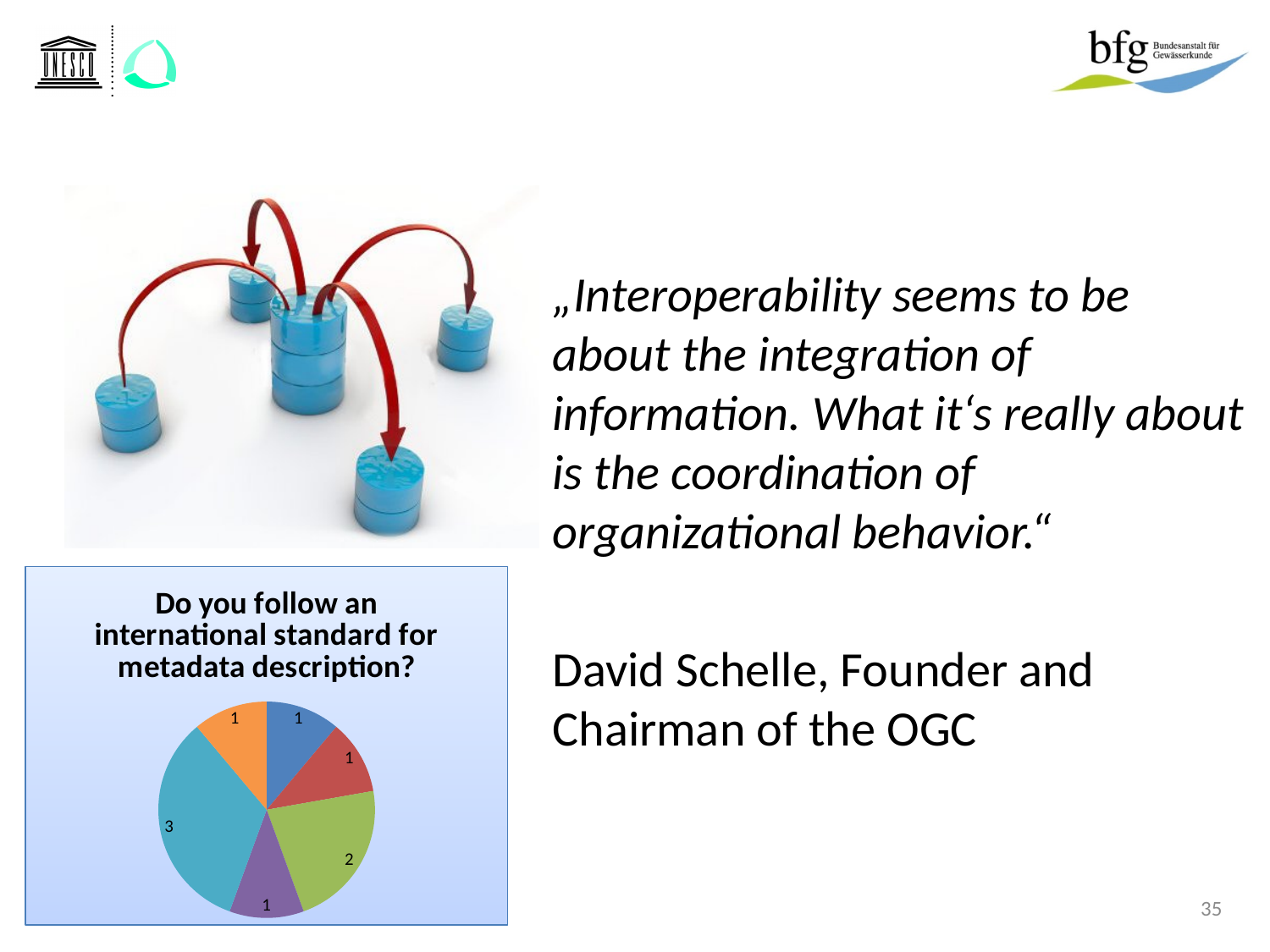
What is the title of the pie chart? Do you follow an international standard for metadata description? Which is larger in the pie chart, the teal slice or the green slice? the teal slice What colour is the largest slice of the pie chart? teal (light blue) How many slices in the pie chart have a value of 1? 4 What is the total of all the values shown on the pie chart? 9 How many slices does the pie chart have? 6 What is the value of the green slice in the pie chart? 2 What is the value of the teal (light blue) slice in the pie chart? 3 What is the value of the smallest slices in the pie chart? 1 What kind of chart is shown on the slide? pie chart What is the value of the largest slice in the pie chart? 3 What is the difference between the largest slice value and the green slice value in the pie chart? 1